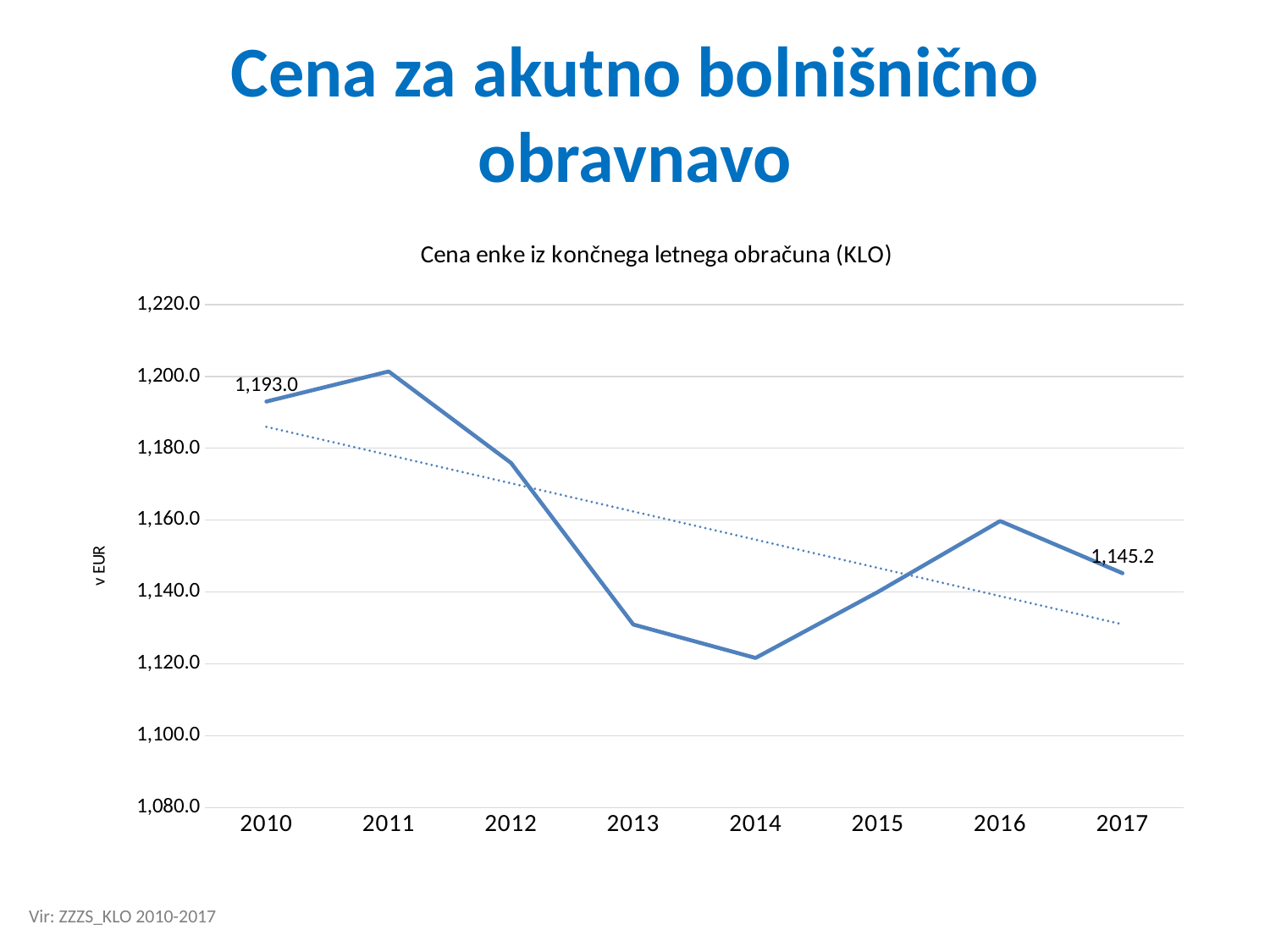
How many years are plotted on the x axis? 8 Which year has the lowest value? 2014 What is the difference between the values for 2010 and 2017? 47.8 What is the value for 2017? 1,145.2 Do the values overall rise or fall from 2010 to 2017? fall What kind of chart is shown? line chart Which year has the highest value? 2011 Is the value for 2016 greater or less than 1,140.0? greater What is the value for 2010? 1,193.0 Is the value for 2014 greater or less than 1,140.0? less Which year has the larger value, 2010 or 2017? 2010 Is the value for 2012 greater or less than 1,160.0? greater